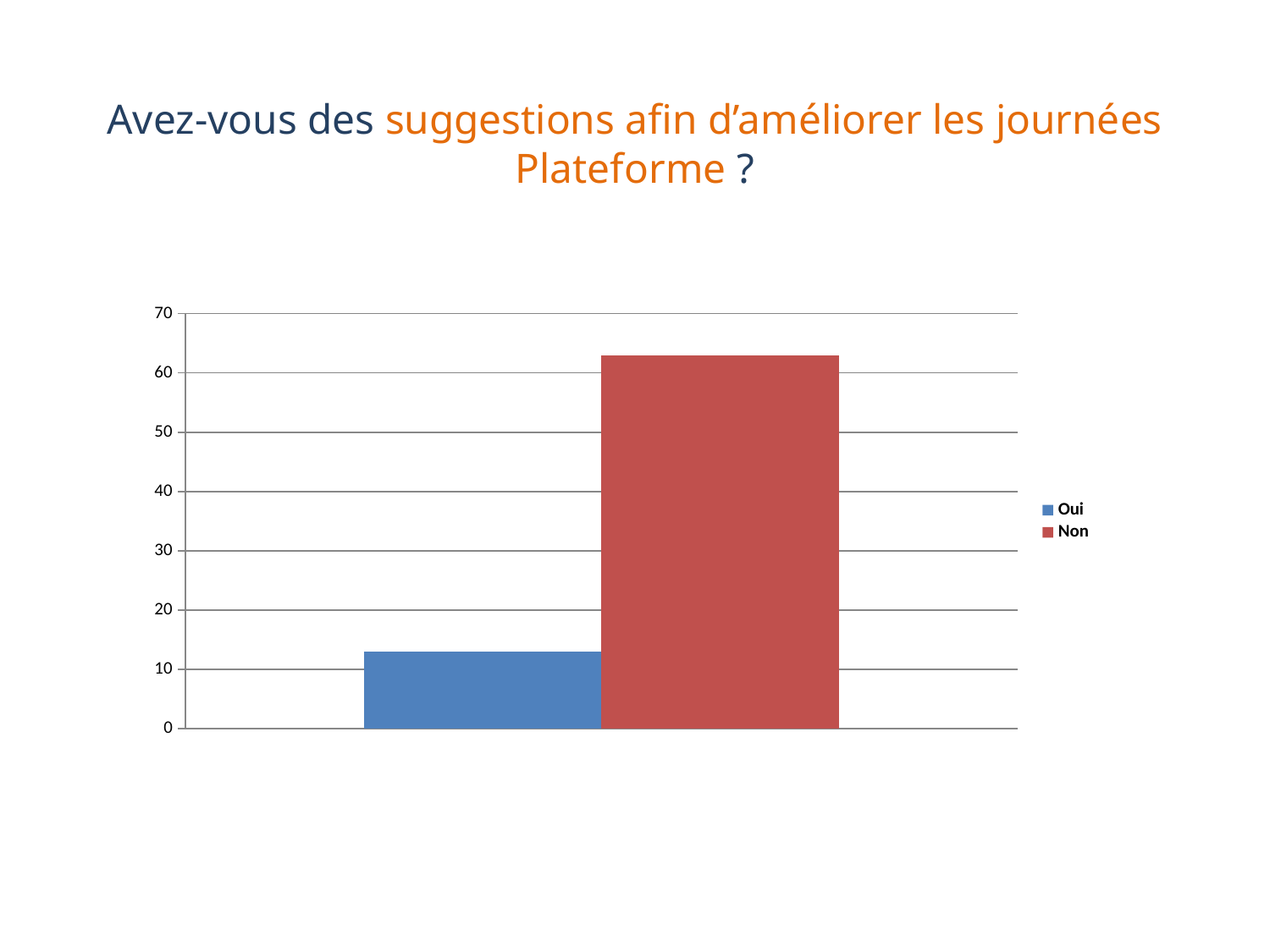
What is the highest value shown on the vertical axis? 70 Is the value for Oui greater or less than 10? greater How many bars are plotted in the chart? 2 What colour is the bar for Non? red Which series has the highest bar, Oui or Non? Non What kind of chart is shown on the slide? bar chart Is the value for Non larger or smaller than the value for Oui? larger Which series has the lowest bar, Oui or Non? Oui How many series does the legend list? 2 Is the value for Non greater or less than 70? less Is the value for Non greater or less than 50? greater